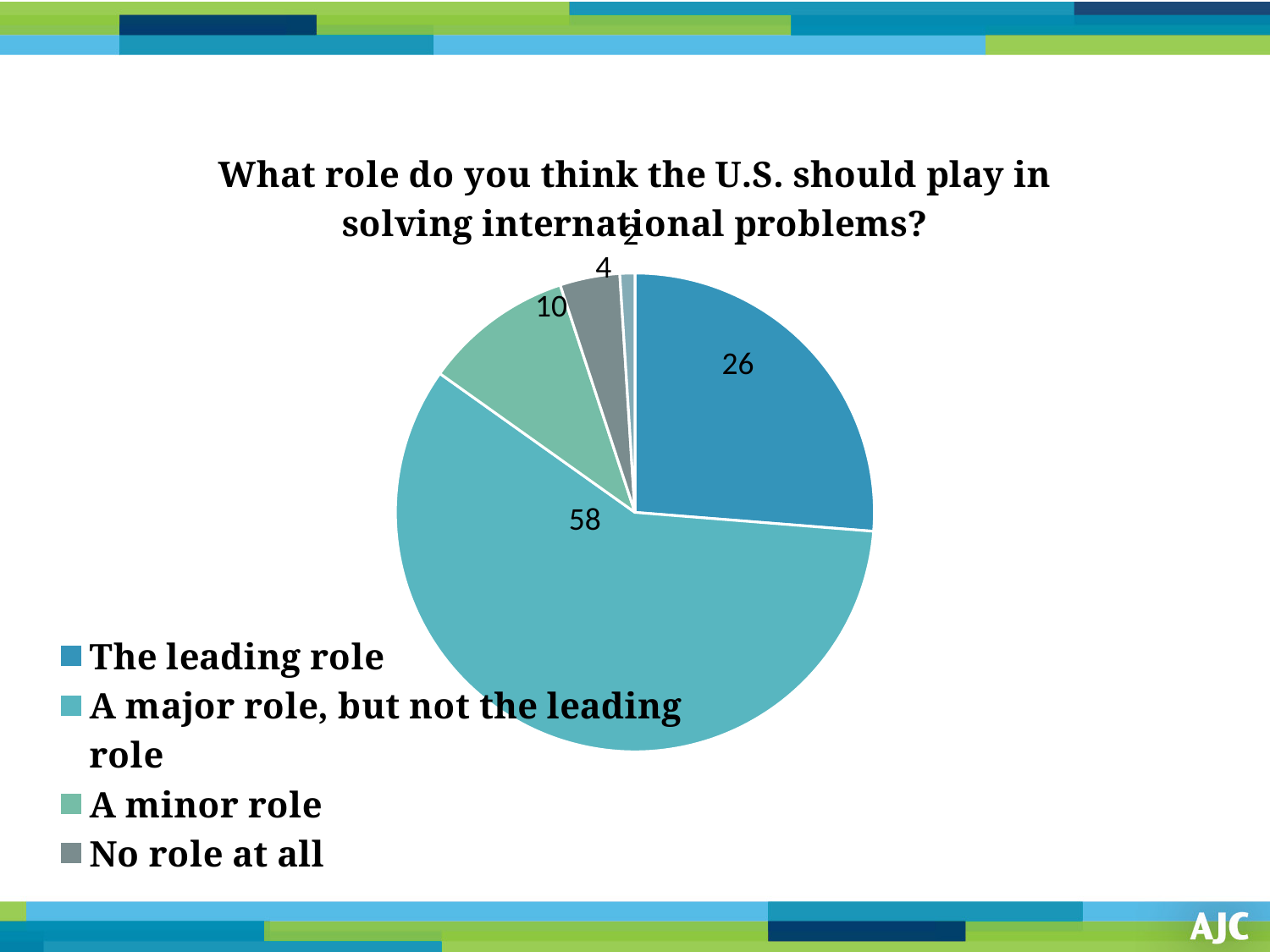
Which is larger, the value for "A minor role" or the value for "No role at all"? A minor role What is the value for "The leading role"? 26 What is the title of the chart? What role do you think the U.S. should play in solving international problems? Which of the legend categories has the smallest slice? No role at all What is the difference between the values for "A major role, but not the leading role" and "The leading role"? 32 What colour is the slice for "No role at all"? gray What is the value for "A minor role"? 10 What is the value for "A major role, but not the leading role"? 58 What kind of chart is shown on the slide? pie chart What is the value for "No role at all"? 4 Which category has the largest slice of the pie? A major role, but not the leading role How many entries does the legend list? 4